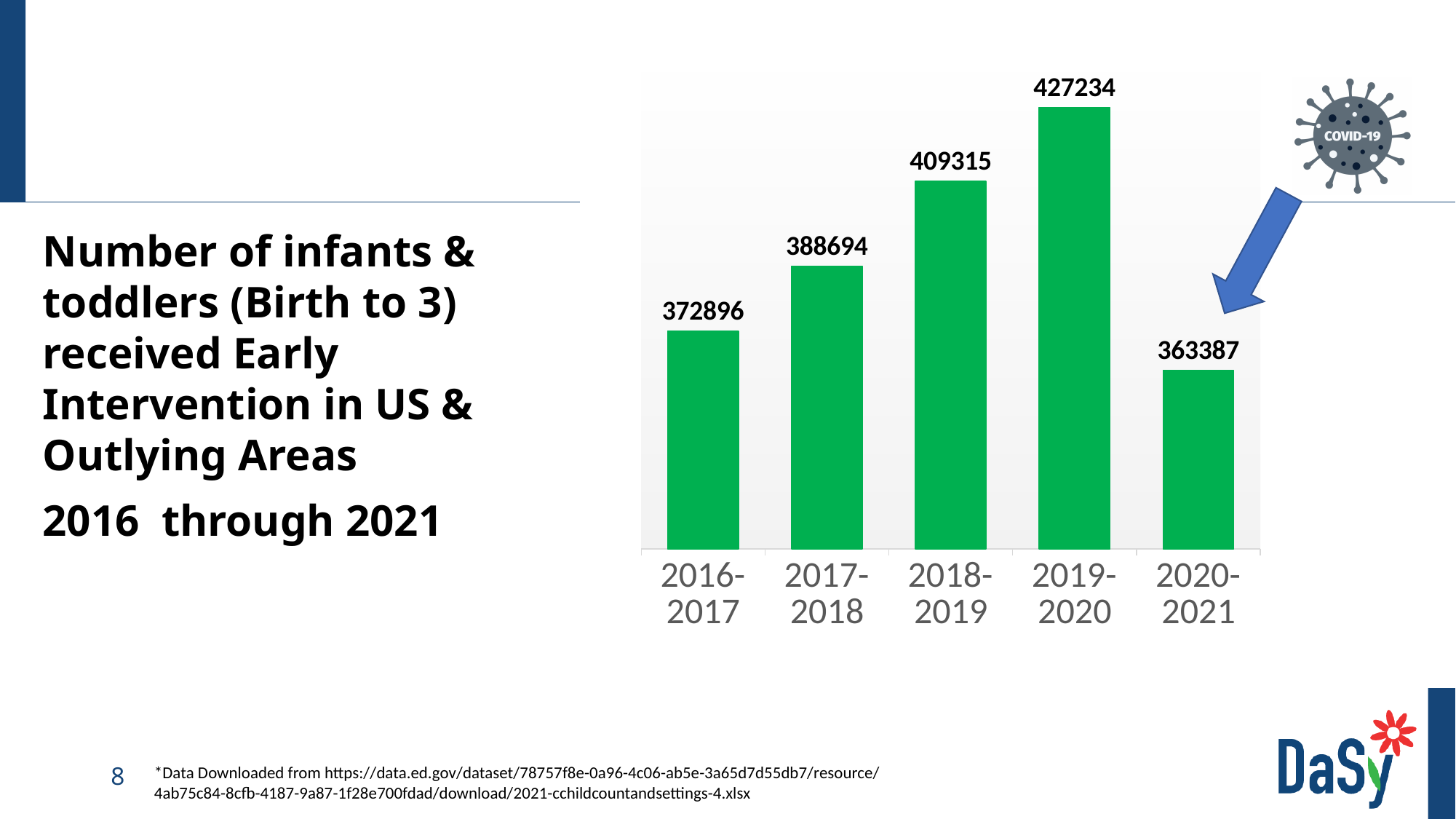
What kind of chart is shown on the slide? Bar chart What is the value for 2016-2017? 372896 Which is larger, the value for 2016-2017 or the value for 2020-2021? 2016-2017 How many years are shown on the chart? 5 What colour are the bars in the chart? Green What is the value for 2018-2019? 409315 Which year has the highest value? 2019-2020 Do the values rise or fall from 2016-2017 to 2019-2020? Rise What is the value for 2020-2021? 363387 What is the difference between the values for 2018-2019 and 2017-2018? 20621 What is the difference between the values for 2019-2020 and 2020-2021? 63847 Which year has the lowest value? 2020-2021